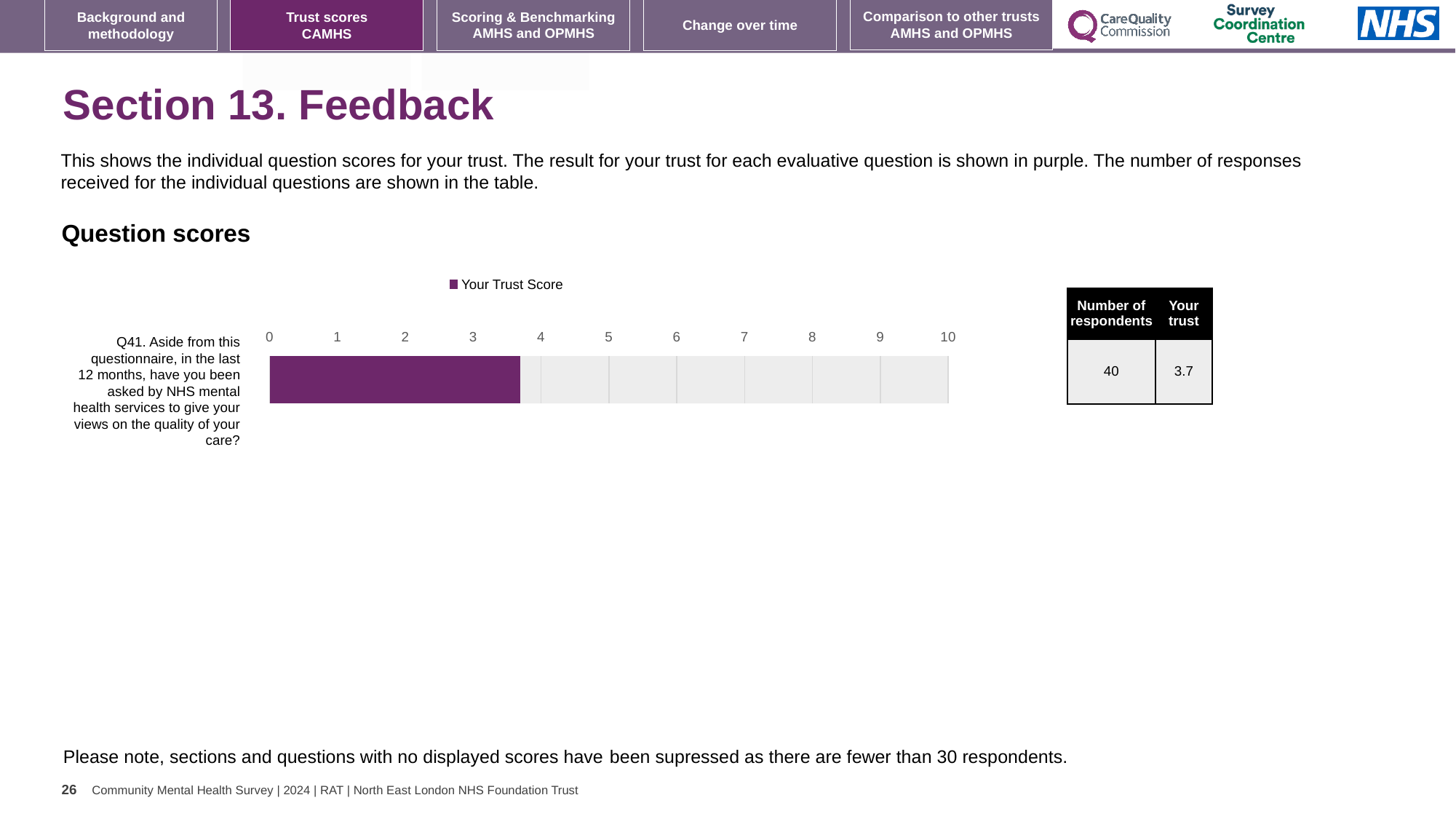
What is the maximum value shown on the x axis of the Question scores chart? 10 How many questions are plotted in the Question scores chart? 1 Which question is plotted in the Question scores chart? Q41. Aside from this questionnaire, in the last 12 months, have you been asked by NHS mental health services to give your views on the quality of your care? What is the trust score for Q41 shown on the slide? 3.7 Is the bar for Q41 greater or less than 5 on the axis? less Is the bar for Q41 greater or less than 3 on the axis? greater What kind of chart is used to show the question scores? bar chart How many respondents answered Q41 according to the table next to the chart? 40 What is the name of the series in the legend of the Question scores chart? Your Trust Score How many series does the legend of the Question scores chart list? 1